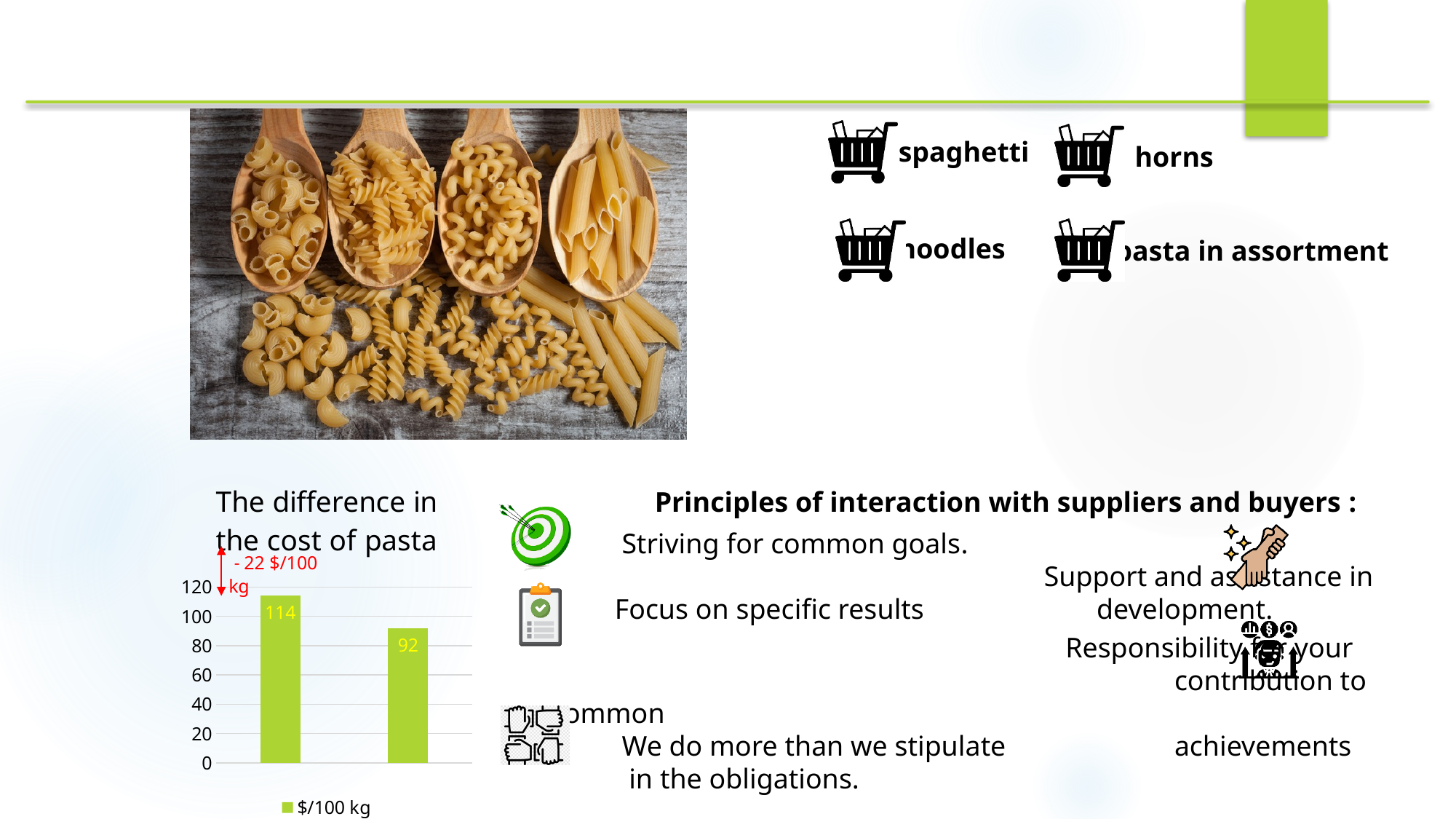
Is the value of the right bar greater or less than 100? less How many series does the chart legend list? 1 What is the difference between the left bar (114) and the right bar (92)? 22 Which bar is taller, the left bar or the right bar? the left bar What is the value of the right bar in the chart? 92 What is the title of the chart on the slide? The difference in the cost of pasta Is the value of the left bar greater or less than 100? greater What is the value of the left bar in the chart? 114 What kind of chart is shown on the slide? bar chart How many bars does the chart show? 2 Do the bar values rise or fall from left to right? fall What is the legend entry of the chart? $/100 kg